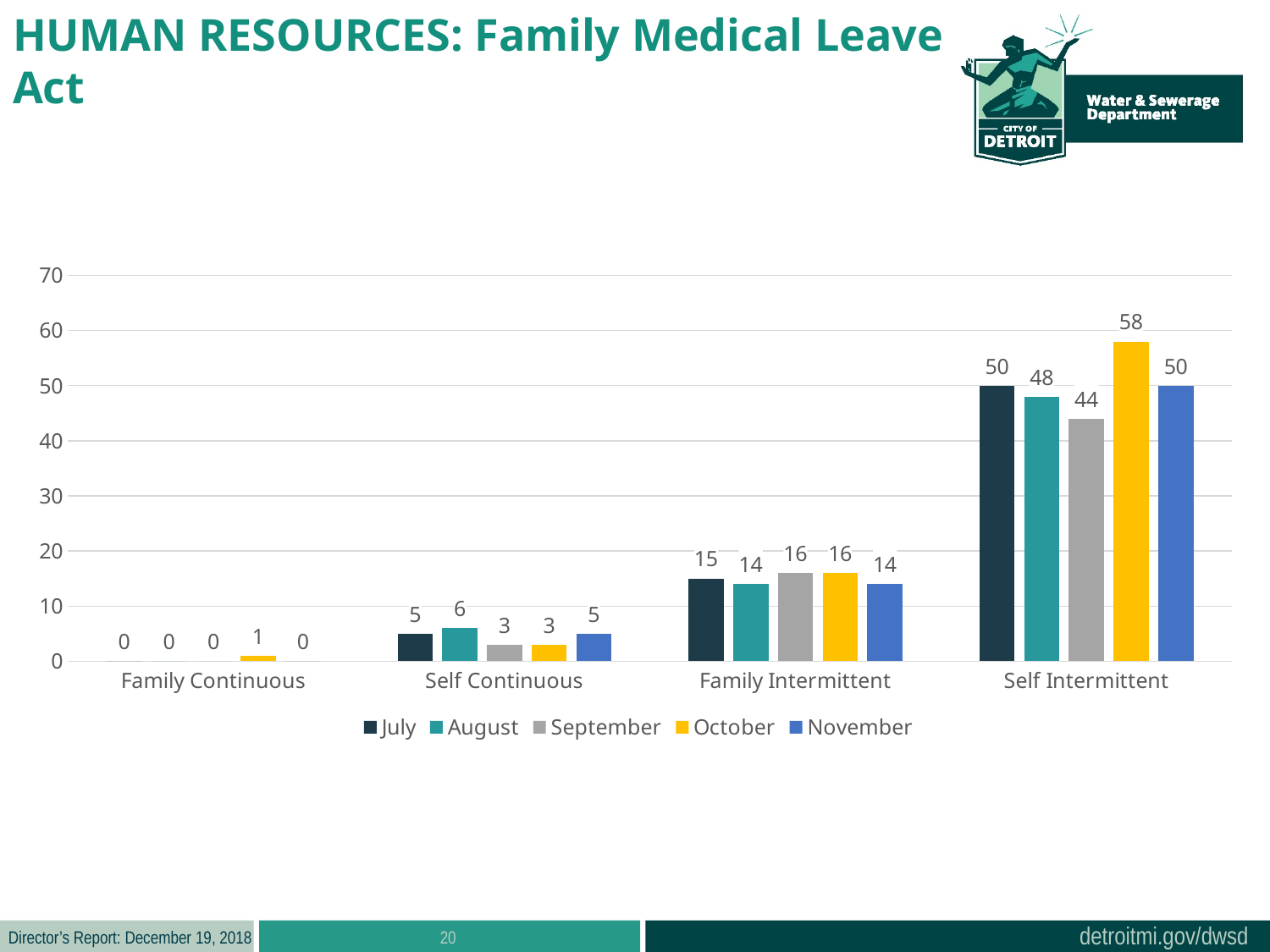
What is the value for October in the Self Intermittent category? 58 Which month is shown in yellow in the legend? October What is the value for September in the Family Intermittent category? 16 Which month has the lowest value in the Self Intermittent category? September How many categories are shown on the x axis? 4 What is the difference between the October and September values in the Self Intermittent category? 14 Which is larger in the Self Continuous category, the July value or the September value? July What is the value for August in the Self Continuous category? 6 Which month has the highest value in the Self Intermittent category? October What kind of chart is shown on the slide? Bar chart How many series does the legend list? 5 What is the value for October in the Family Continuous category? 1